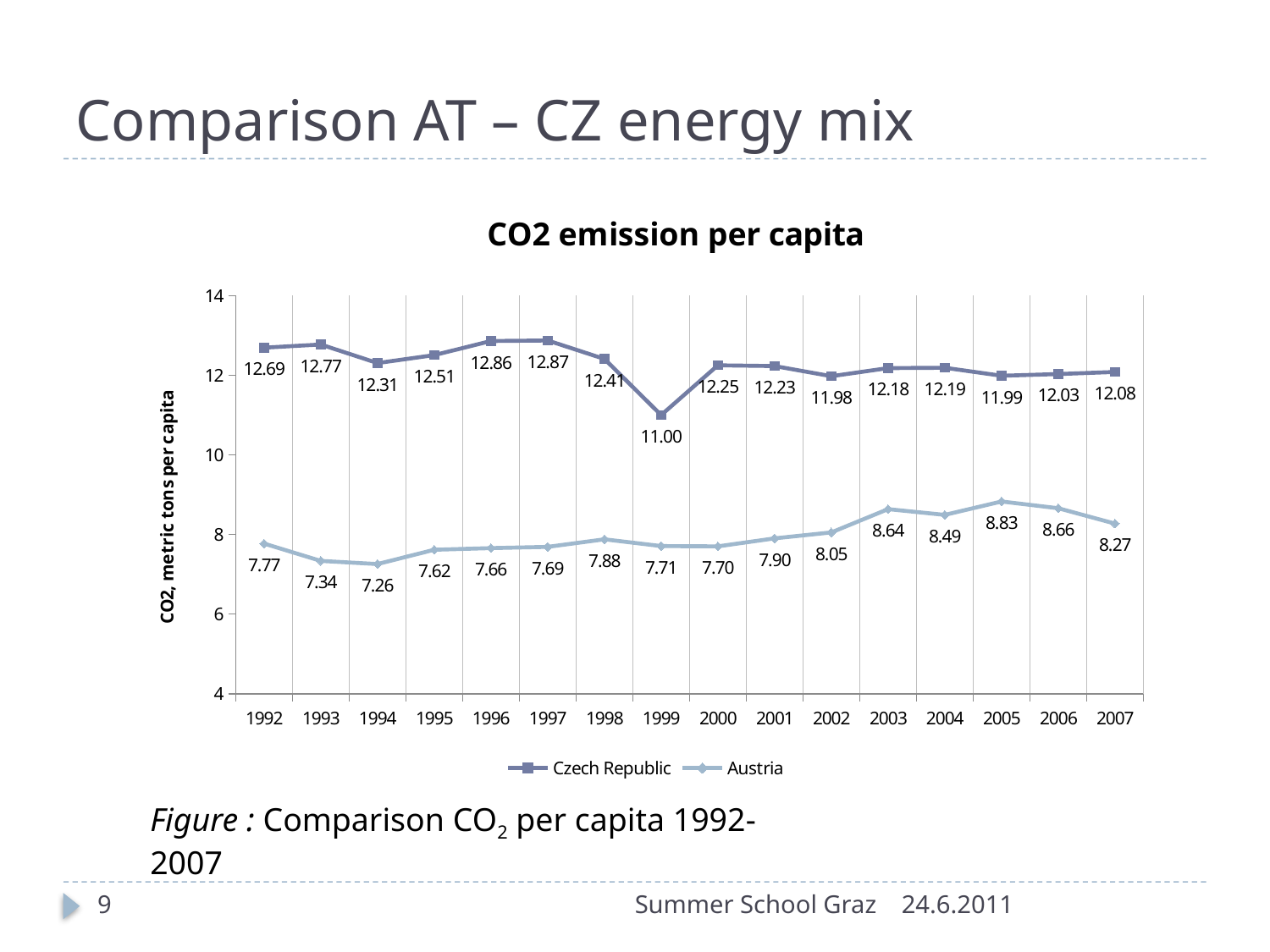
In which year is Austria's CO2 emission per capita lowest? 1994 What is the CO2 emission per capita for Austria in 1992? 7.77 What is the CO2 emission per capita for the Czech Republic in 1999? 11.00 What is the CO2 emission per capita for Austria in 2005? 8.83 Which country has the higher CO2 emission per capita in 2003? Czech Republic How many years are shown on the x axis? 16 Does Austria's CO2 emission per capita rise or fall from 2002 to 2005? Rise What kind of chart is shown on the slide? Line chart What is the title of the chart? CO2 emission per capita What is the difference between the Czech Republic and Austria CO2 emission per capita in 2007? 3.81 In which year is the Czech Republic's CO2 emission per capita highest? 1997 How many series does the legend list? 2